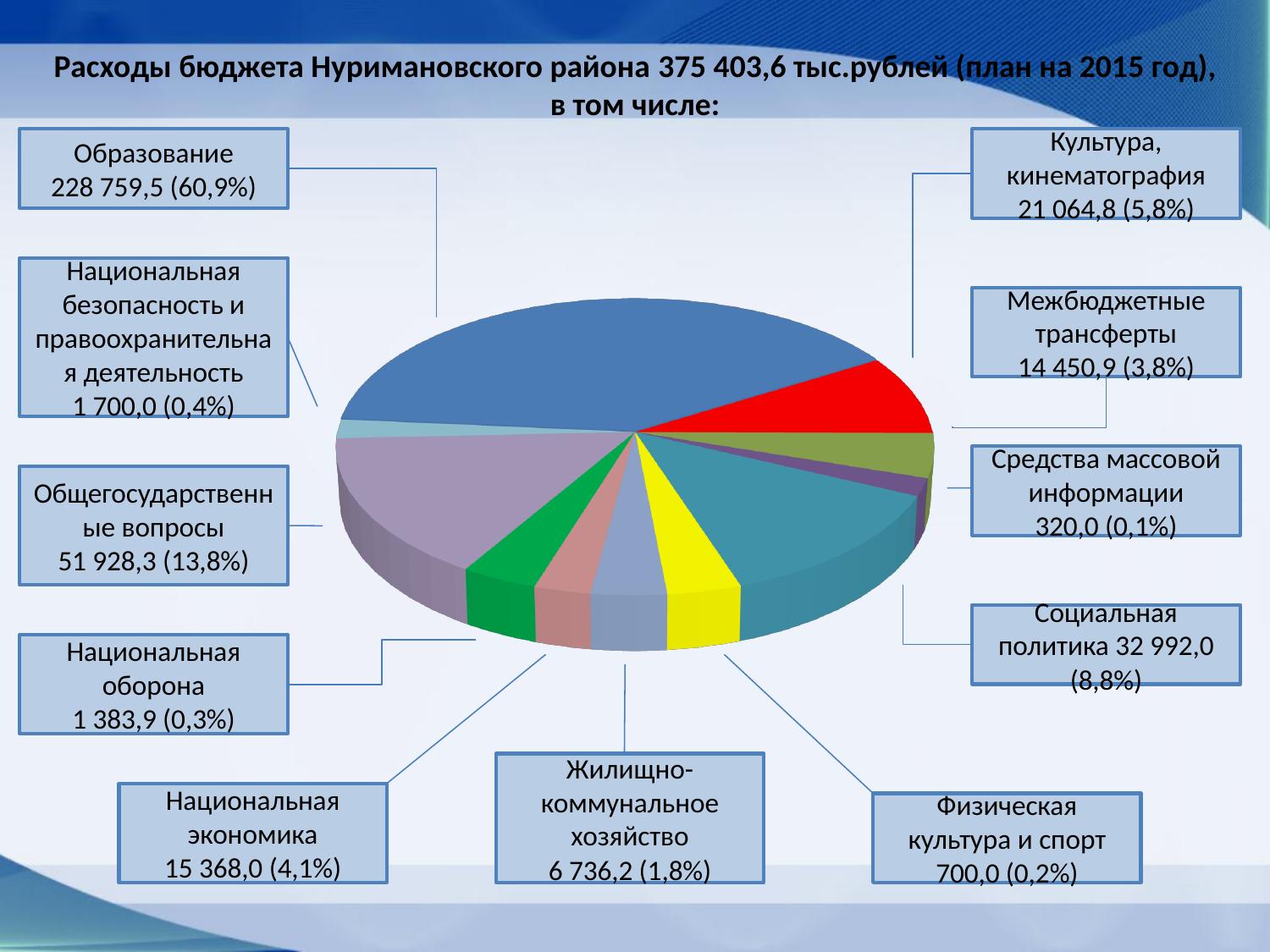
How many categories are shown in the pie chart? 11 What is the planned expenditure for Образование (education)? 228 759,5 What is the share of Культура, кинематография? 5,8% What kind of chart is shown on the slide? pie chart Which category has the smallest share of the budget? Средства массовой информации What is the value for Социальная политика? 32 992,0 What is the value for Физическая культура и спорт? 700,0 Which is larger: Национальная экономика or Межбюджетные трансферты? Национальная экономика Which category has the largest share of the budget? Образование What share of the budget does Общегосударственные вопросы account for? 13,8% What is the total budget expenditure stated in the slide title? 375 403,6 тыс.рублей What is the difference in percentage share between Образование and Общегосударственные вопросы? 47,1%